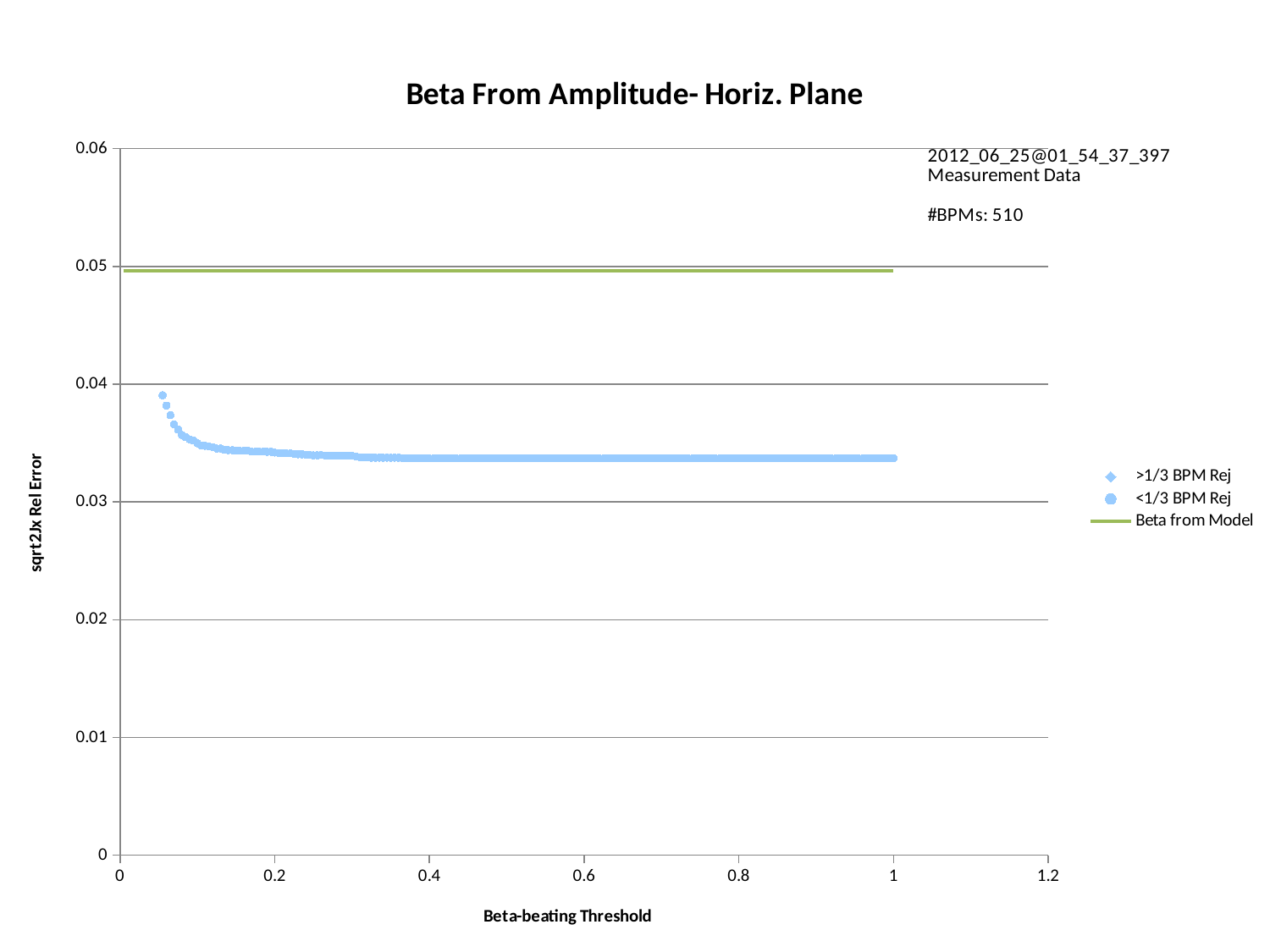
How many BPMs does the slide state were used? 510 Is the value of the Beta from Model line greater or less than 0.04? greater Is the value of the Beta from Model line greater or less than 0.06? less Which is higher on the chart, the Beta from Model line or the <1/3 BPM Rej points? Beta from Model What is the label of the x axis? Beta-beating Threshold What is the title of the chart? Beta From Amplitude- Horiz. Plane Is the value of the <1/3 BPM Rej series at a Beta-beating Threshold of 1 greater or less than 0.04? less How many series does the legend list? 3 What kind of chart is this? scatter chart Do the <1/3 BPM Rej values rise or fall as the Beta-beating Threshold increases? fall